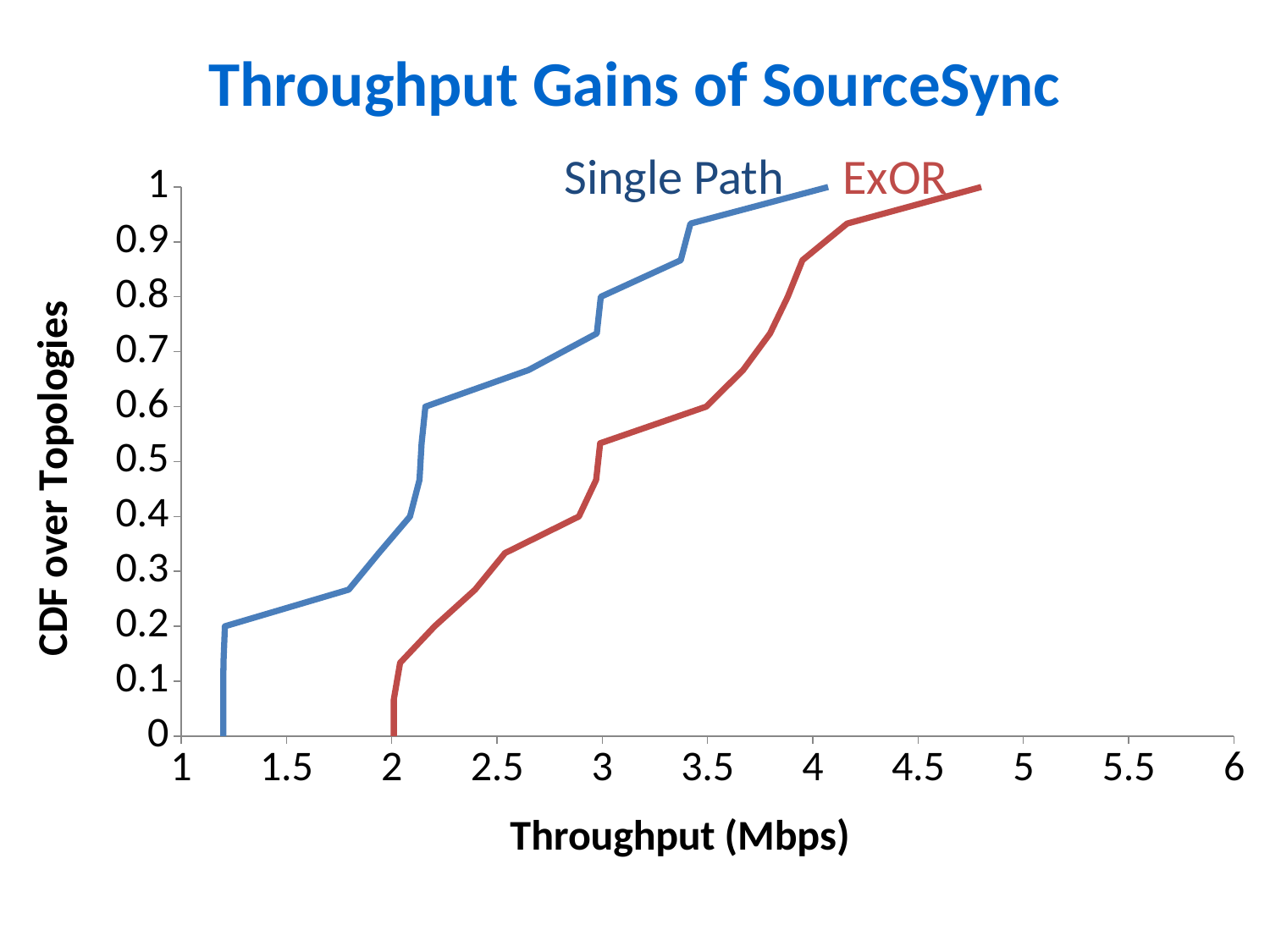
What is the label of the y axis? CDF over Topologies How many series are plotted on the chart? 2 Is the CDF value for Single Path at a throughput of 2.5 Mbps greater or less than 0.5? greater What kind of chart is shown on the slide? line chart Do the CDF values for Single Path rise or fall as throughput increases along the x axis? rise What is the title of the chart on the slide? Throughput Gains of SourceSync Is the CDF value for ExOR at a throughput of 2.5 Mbps greater or less than 0.5? less At what throughput (Mbps) does the ExOR curve start at a CDF of 0? 2 Which series reaches a CDF of 1 at the higher throughput, Single Path or ExOR? ExOR Is the CDF value for ExOR at a throughput of 3 Mbps greater or less than 0.6? less Which series has the higher CDF value at a throughput of 3 Mbps, Single Path or ExOR? Single Path